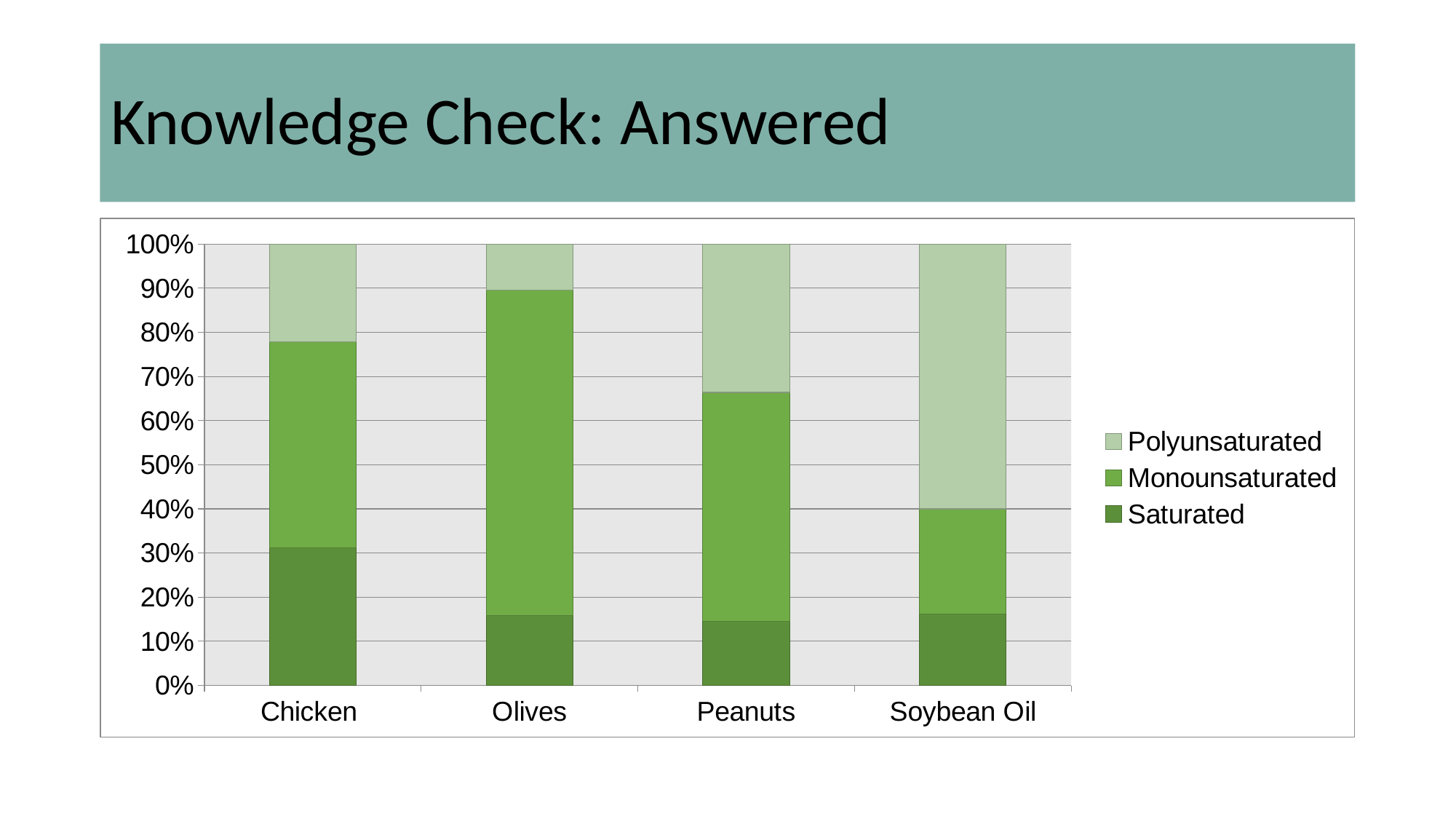
Which category has the largest Monounsaturated share? Olives Is the Saturated value for Chicken greater or less than 20%? greater Which is larger, the Saturated share for Chicken or the Saturated share for Olives? Chicken How many categories are shown on the x axis of the chart? 4 Which category has the smallest Polyunsaturated share? Olives Is the Polyunsaturated value for Soybean Oil greater or less than 50%? greater Which category has the smallest Monounsaturated share? Soybean Oil How many series does the chart's legend list? 3 Which category has the largest Polyunsaturated share? Soybean Oil Which category has the largest Saturated share? Chicken What kind of chart is shown on the slide? stacked bar chart Which series is shown in the lightest green in the legend? Polyunsaturated